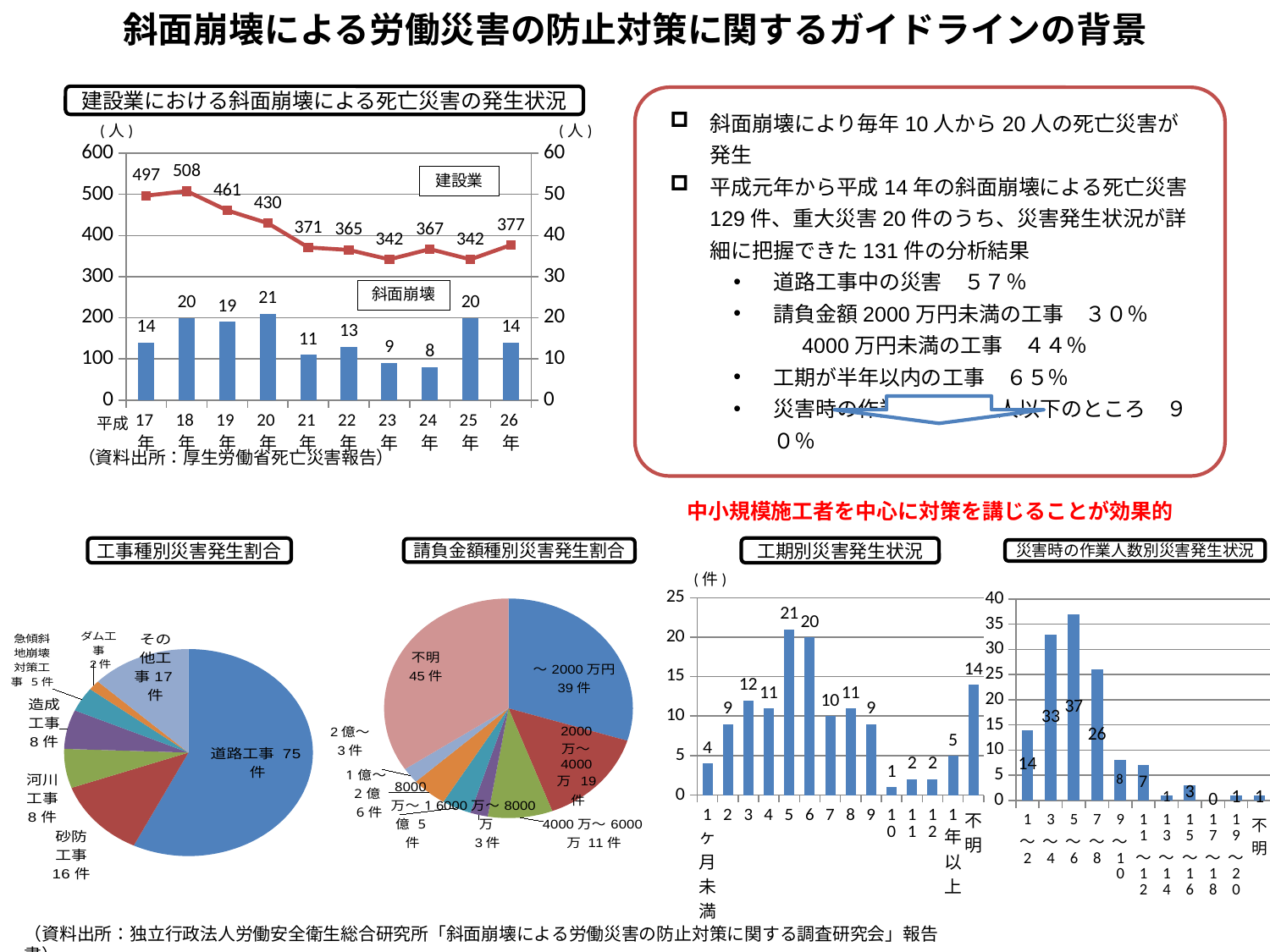
In the bar chart '工期別災害発生状況', what is the value for 5ヶ月? 21 In the top-left chart '建設業における斜面崩壊による死亡災害の発生状況', what is the 建設業 value for 平成18年? 508 In the pie chart '請負金額種別災害発生割合', which is larger, ～2000万円 or 2000万～4000万? ～2000万円 In the top-left chart '建設業における斜面崩壊による死亡災害の発生状況', which year has the highest 斜面崩壊 value? 平成20年 In the bar chart '災害時の作業人数別災害発生状況', which category has the highest value? 5～6 What type of chart is '災害時の作業人数別災害発生状況'? bar chart In the top-left chart '建設業における斜面崩壊による死亡災害の発生状況', how many series does the chart show? 2 In the pie chart '工事種別災害発生割合', which category has the smallest slice? ダム工事 In the top-left chart '建設業における斜面崩壊による死亡災害の発生状況', what is the 斜面崩壊 value for 平成24年? 8 In the top-left chart '建設業における斜面崩壊による死亡災害の発生状況', what is the difference between the 建設業 values for 平成17年 and 平成26年? 120 In the pie chart '請負金額種別災害発生割合', how many cases are in the 不明 category? 45件 In the pie chart '工事種別災害発生割合', how many cases are attributed to 道路工事? 75件